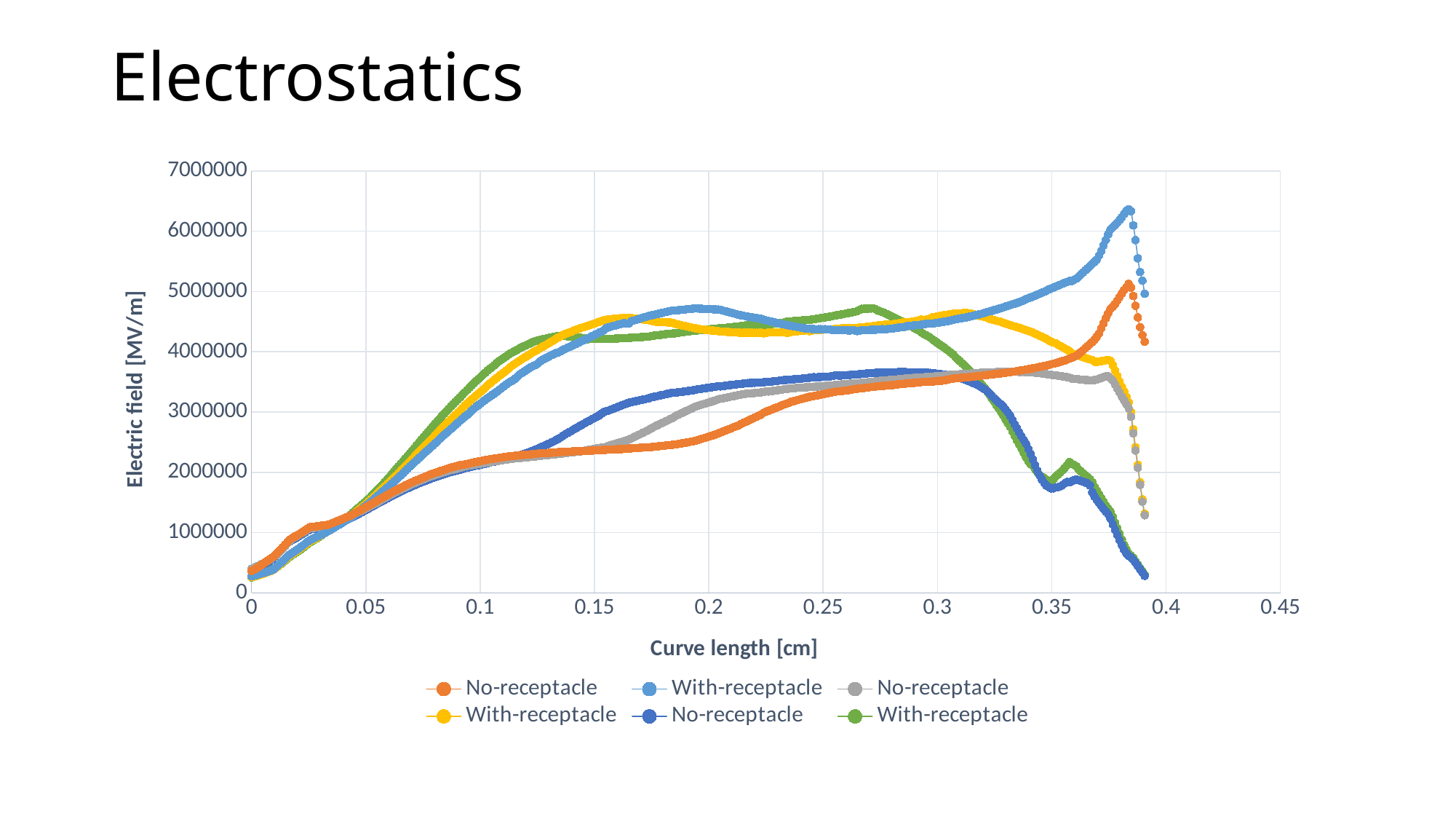
At a curve length of 0.2, which is larger: the light blue With-receptacle series or the orange No-receptacle series? the light blue With-receptacle series Is the value of the dark blue No-receptacle series at a curve length of 0.35 greater or less than 2000000? less Is the value of the green With-receptacle series at a curve length of 0.27 greater or less than 4000000? greater What is the label of the x axis? Curve length [cm] Does the dark blue No-receptacle series rise or fall between curve lengths of 0.3 and 0.35? fall How many series does the legend list? 6 What is the highest value shown on the y axis? 7000000 What kind of chart is shown on the slide? line chart Is the peak value of the orange No-receptacle series greater or less than 4000000? greater What is the label of the y axis? Electric field [MV/m] Which series reaches the highest electric field value on the chart? the light blue With-receptacle series